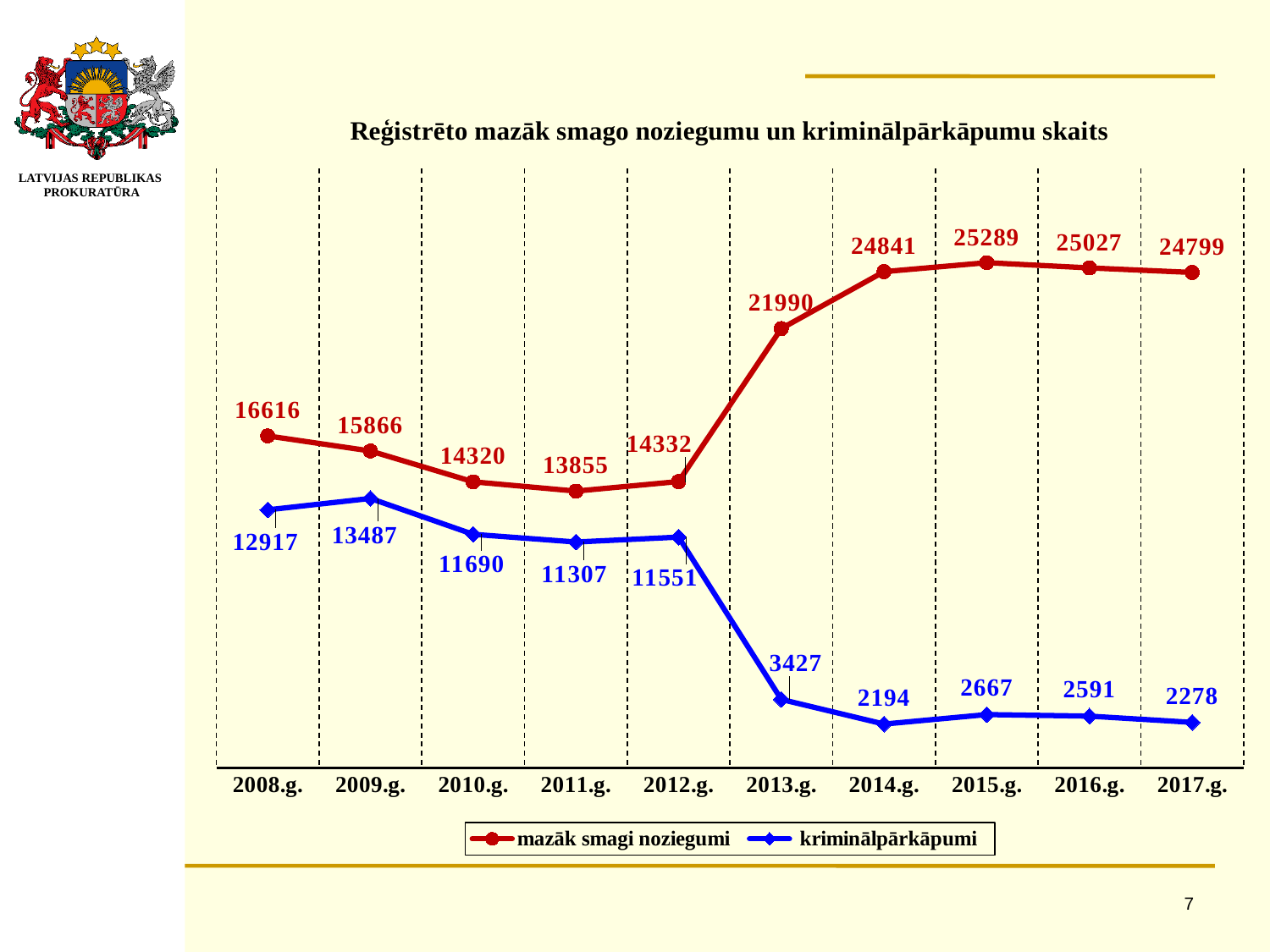
What type of chart is shown on the slide? line chart Which colour is used for the kriminālpārkāpumi series? blue In which year is the value for mazāk smagi noziegumi highest? 2015.g. What is the value for mazāk smagi noziegumi in 2013.g.? 21990 How many series does the legend list? 2 What is the title of the chart? Reģistrēto mazāk smago noziegumu un kriminālpārkāpumu skaits In which year is the value for kriminālpārkāpumi lowest? 2014.g. What is the difference between the mazāk smagi noziegumi values for 2014.g. and 2013.g.? 2851 Does the kriminālpārkāpumi series rise or fall between 2012.g. and 2013.g.? fall What is the value for kriminālpārkāpumi in 2009.g.? 13487 How many years are shown on the x axis? 10 Which is larger: the kriminālpārkāpumi value for 2012.g. or for 2013.g.? 2012.g.